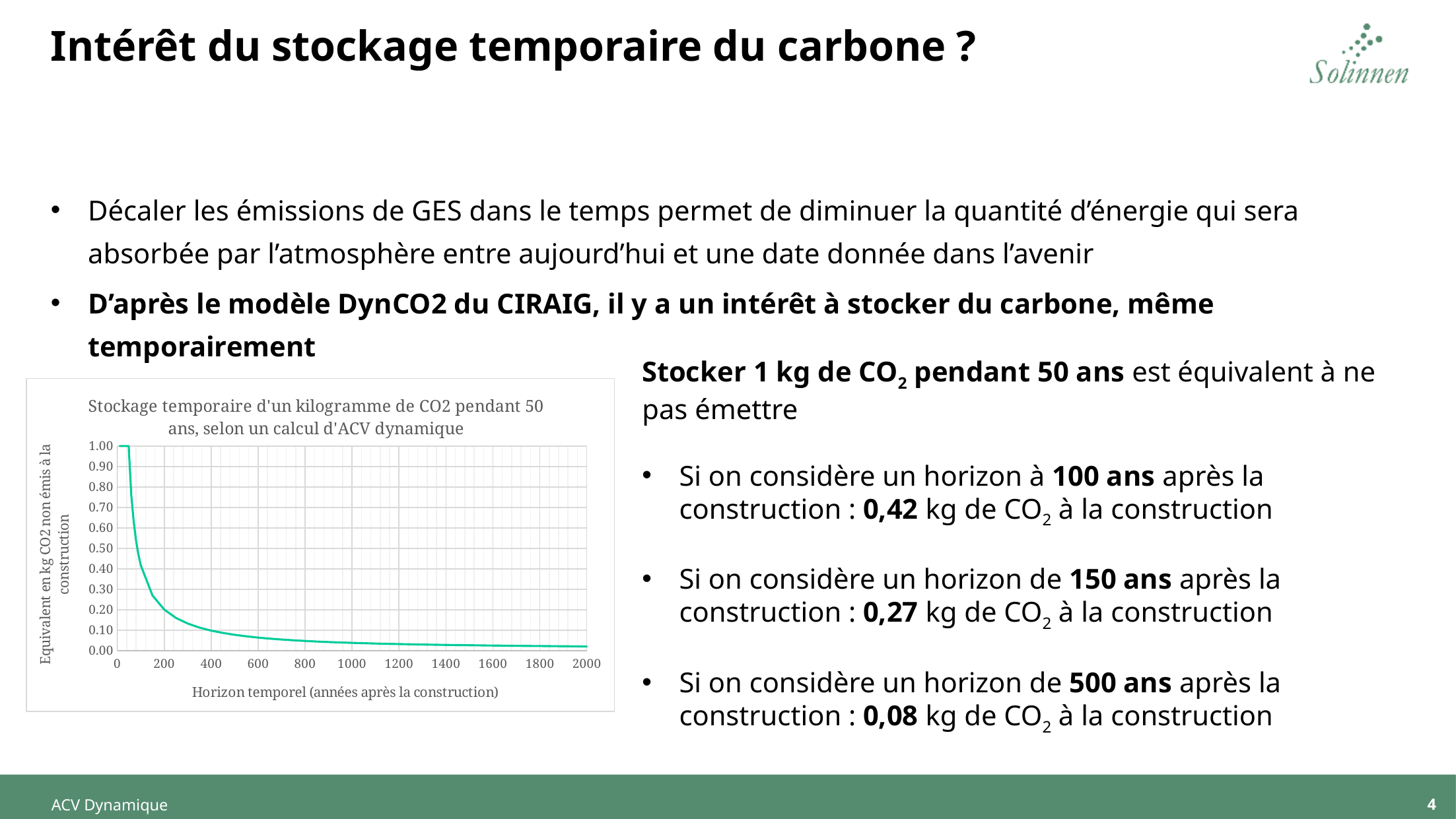
Is the value at a horizon of 1000 years greater or less than 0.10? less Is the value at a horizon of 100 years greater or less than 0.30? greater Does the plotted value rise or fall as the time horizon increases along the x axis? fall Is the value at a horizon of 2000 years greater or less than 0.10? less Which is larger: the value at a horizon of 200 years or at 1000 years? 200 years What kind of chart is shown on the slide? line chart What is the title of the chart? Stockage temporaire d'un kilogramme de CO2 pendant 50 ans, selon un calcul d'ACV dynamique What is the largest horizon value shown on the x axis? 2000